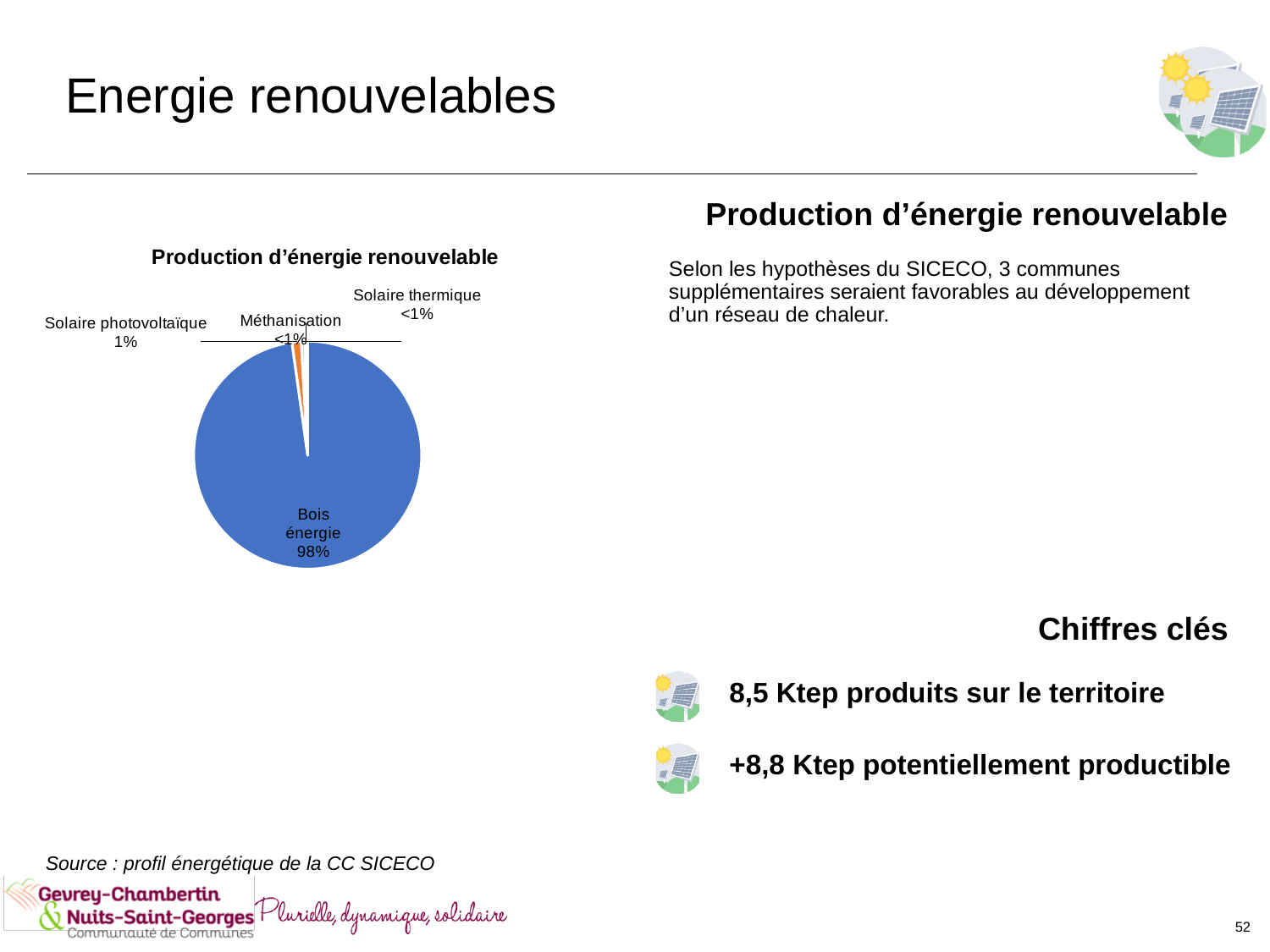
Which is larger, the share for Bois énergie or the share for Solaire photovoltaïque? Bois énergie How many categories are shown in the pie chart? 4 What share is shown for Solaire thermique? <1% What is the title of the chart? Production d'énergie renouvelable What share of the pie does Bois énergie represent? 98% Which category has the largest slice of the pie? Bois énergie What share of the pie does Solaire photovoltaïque represent? 1% What is the difference between the share for Bois énergie and the share for Solaire photovoltaïque? 97% What kind of chart is shown on the slide? pie chart What colour is the Bois énergie slice? blue What share is shown for Méthanisation? <1%